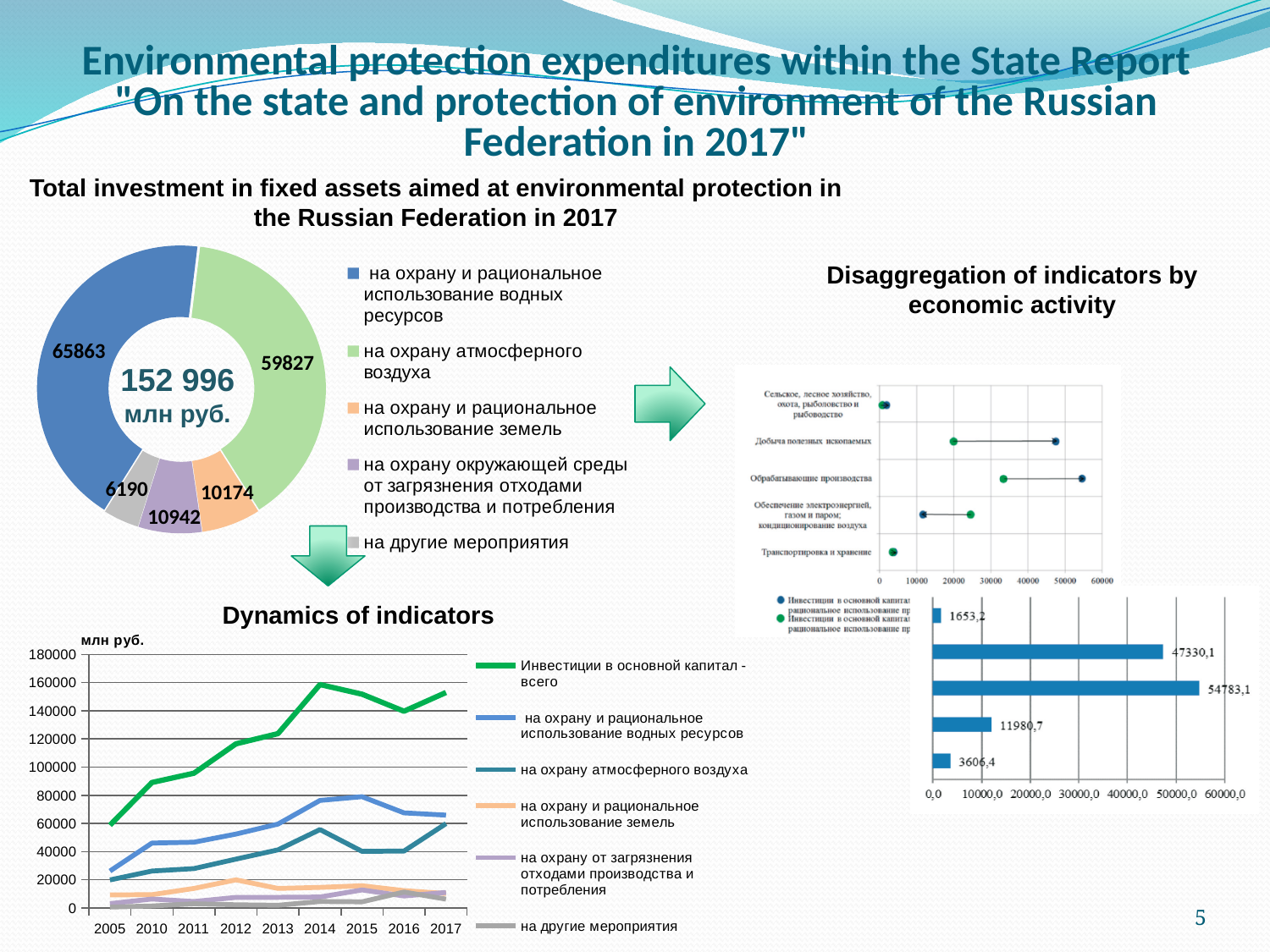
On the bar chart at the bottom right of the slide, what is the largest labelled value? 54783,1 On the donut chart 'Total investment in fixed assets aimed at environmental protection in the Russian Federation in 2017', how many categories are shown? 5 On the donut chart 'Total investment in fixed assets aimed at environmental protection in the Russian Federation in 2017', what is the value for 'на охрану и рациональное использование водных ресурсов'? 65863 On the 'Dynamics of indicators' chart, how many years are shown on the x axis? 9 On the donut chart 'Total investment in fixed assets aimed at environmental protection in the Russian Federation in 2017', what total is shown in the centre of the chart? 152 996 млн руб. On the donut chart 'Total investment in fixed assets aimed at environmental protection in the Russian Federation in 2017', what is the difference between the values for 'на охрану и рациональное использование водных ресурсов' and 'на охрану атмосферного воздуха'? 6036 On the 'Dynamics of indicators' chart, how many series does the legend list? 6 On the 'Dynamics of indicators' chart, is the value for 'Инвестиции в основной капитал - всего' in 2017 greater or less than 140000? greater On the 'Dynamics of indicators' chart, does the series 'Инвестиции в основной капитал - всего' generally rise or fall from 2005 to 2017? rise On the donut chart 'Total investment in fixed assets aimed at environmental protection in the Russian Federation in 2017', what is the value for 'на охрану атмосферного воздуха'? 59827 On the donut chart 'Total investment in fixed assets aimed at environmental protection in the Russian Federation in 2017', which category has the smallest value? на другие мероприятия On the donut chart 'Total investment in fixed assets aimed at environmental protection in the Russian Federation in 2017', which is larger: 'на охрану и рациональное использование земель' or 'на охрану окружающей среды от загрязнения отходами производства и потребления'? на охрану окружающей среды от загрязнения отходами производства и потребления